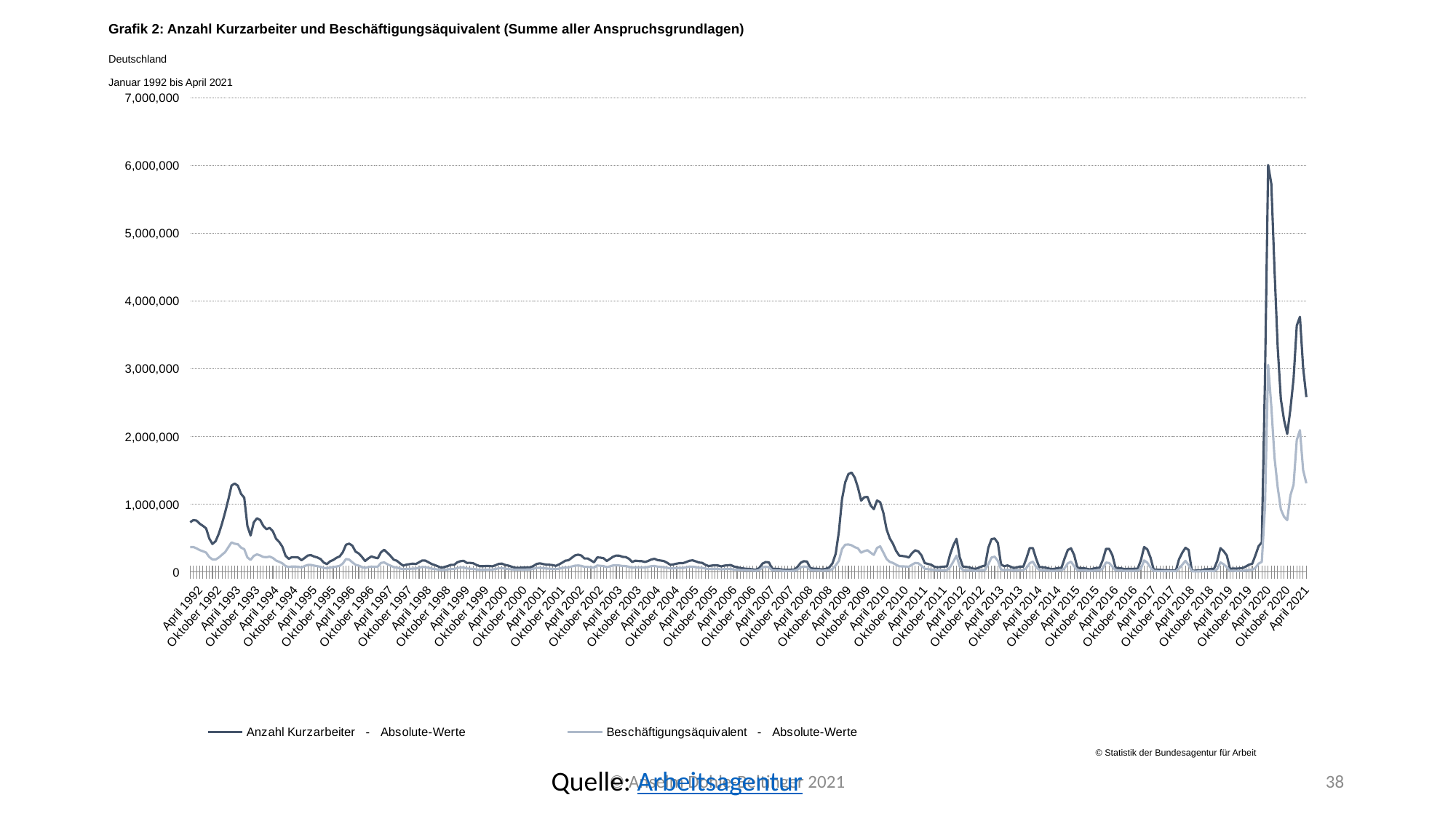
Is the value of Anzahl Kurzarbeiter at April 2021 greater or less than 2,000,000? greater Which series reaches the higher peak in 2020, Anzahl Kurzarbeiter or Beschäftigungsäquivalent? Anzahl Kurzarbeiter Is the value of Beschäftigungsäquivalent at April 2009 greater or less than 1,000,000? less What is the title of the chart? Grafik 2: Anzahl Kurzarbeiter und Beschäftigungsäquivalent (Summe aller Anspruchsgrundlagen) What kind of chart is shown on the slide? line chart Around which x-axis label does the Anzahl Kurzarbeiter series reach its highest value? April 2020 Is the peak value of Beschäftigungsäquivalent in 2020 greater or less than 4,000,000? less How many series does the legend list? 2 What period does the chart cover according to the subtitle? Januar 1992 bis April 2021 Does the Anzahl Kurzarbeiter series rise or fall between Oktober 2019 and April 2020? rise